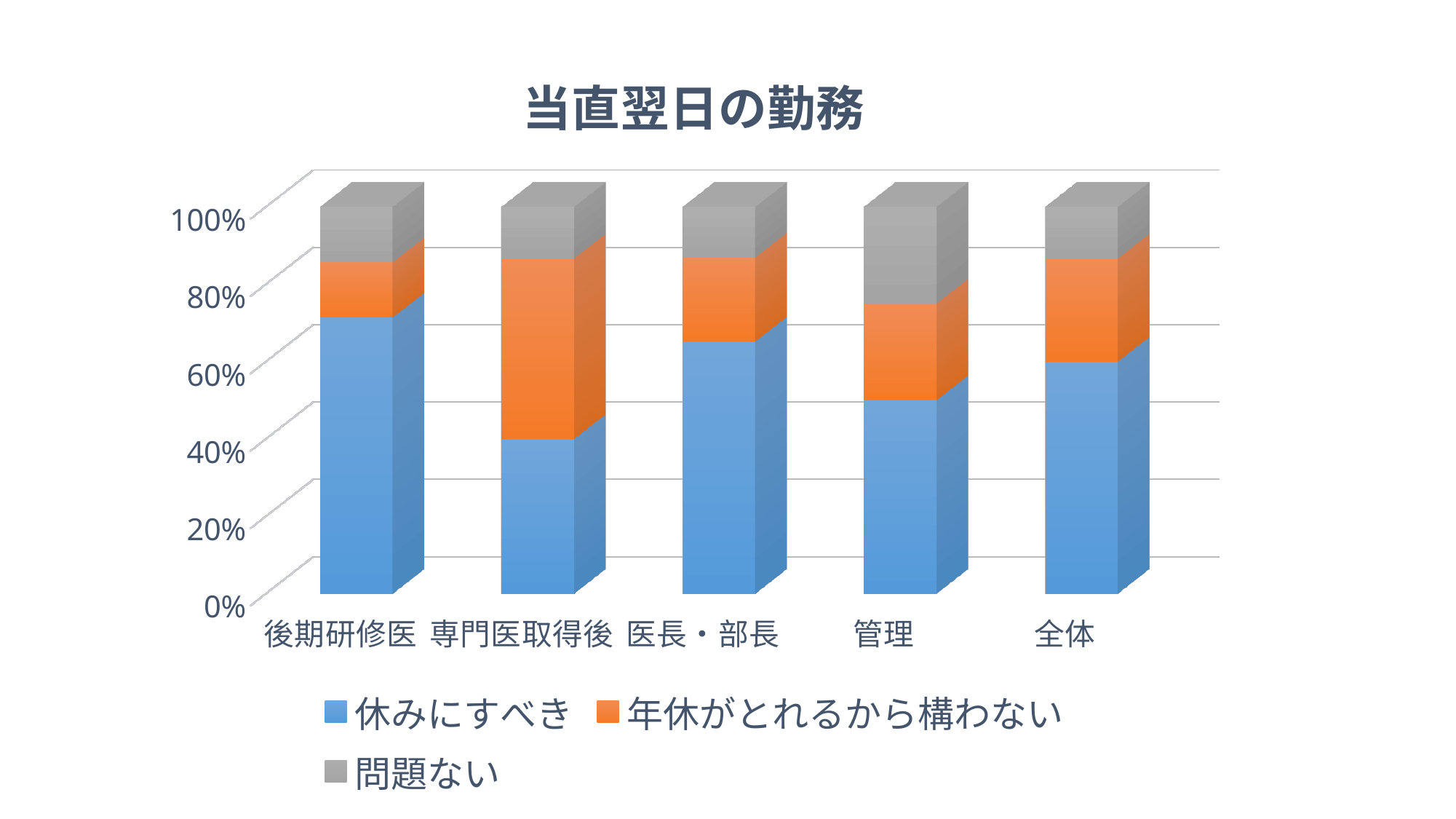
Is the 休みにすべき share for 専門医取得後 greater or less than 60%? less Which series is shown in orange in the legend? 年休がとれるから構わない Which category has the largest 休みにすべき share? 後期研修医 How many series does the legend list? 3 Which category has the smallest 休みにすべき share? 専門医取得後 What is the title of the chart? 当直翌日の勤務 Is the 休みにすべき share for 後期研修医 greater or less than 60%? greater What kind of chart is shown on the slide? Stacked bar chart Which has a larger 休みにすべき share, 医長・部長 or 管理? 医長・部長 Which category has the largest 年休がとれるから構わない share? 専門医取得後 Which category has the largest 問題ない share? 管理 How many categories are shown on the x axis? 5